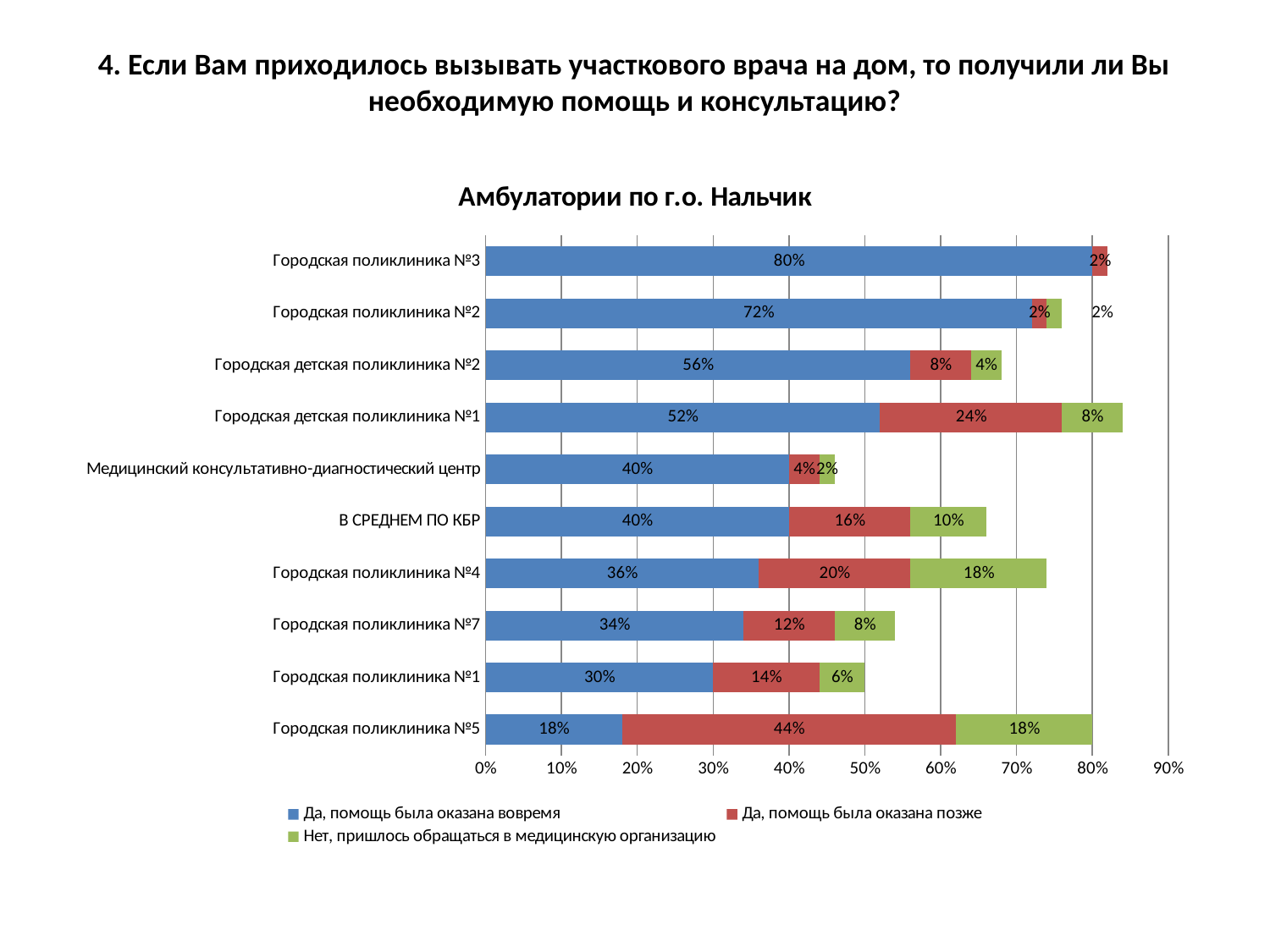
What is the value of "Да, помощь была оказана вовремя" for Городская поликлиника №3? 80% What is the value of "Нет, пришлось обращаться в медицинскую организацию" for Городская поликлиника №4? 18% Which is larger: the "Да, помощь была оказана позже" value for Городская детская поликлиника №1 or for Городская поликлиника №7? Городская детская поликлиника №1 How many series does the legend list? 3 What kind of chart is shown on the slide? stacked bar chart What is the value of "Да, помощь была оказана позже" for Городская поликлиника №5? 44% What is the title of the chart? Амбулатории по г.о. Нальчик What is the total of the stacked bar for Городская поликлиника №5? 80% What is the difference between the "Да, помощь была оказана вовремя" values for Городская поликлиника №2 and Городская поликлиника №1? 42% Which category has the lowest value for "Да, помощь была оказана вовремя"? Городская поликлиника №5 Which category has the highest value for "Да, помощь была оказана вовремя"? Городская поликлиника №3 How many categories (clinics) are plotted on the chart? 10